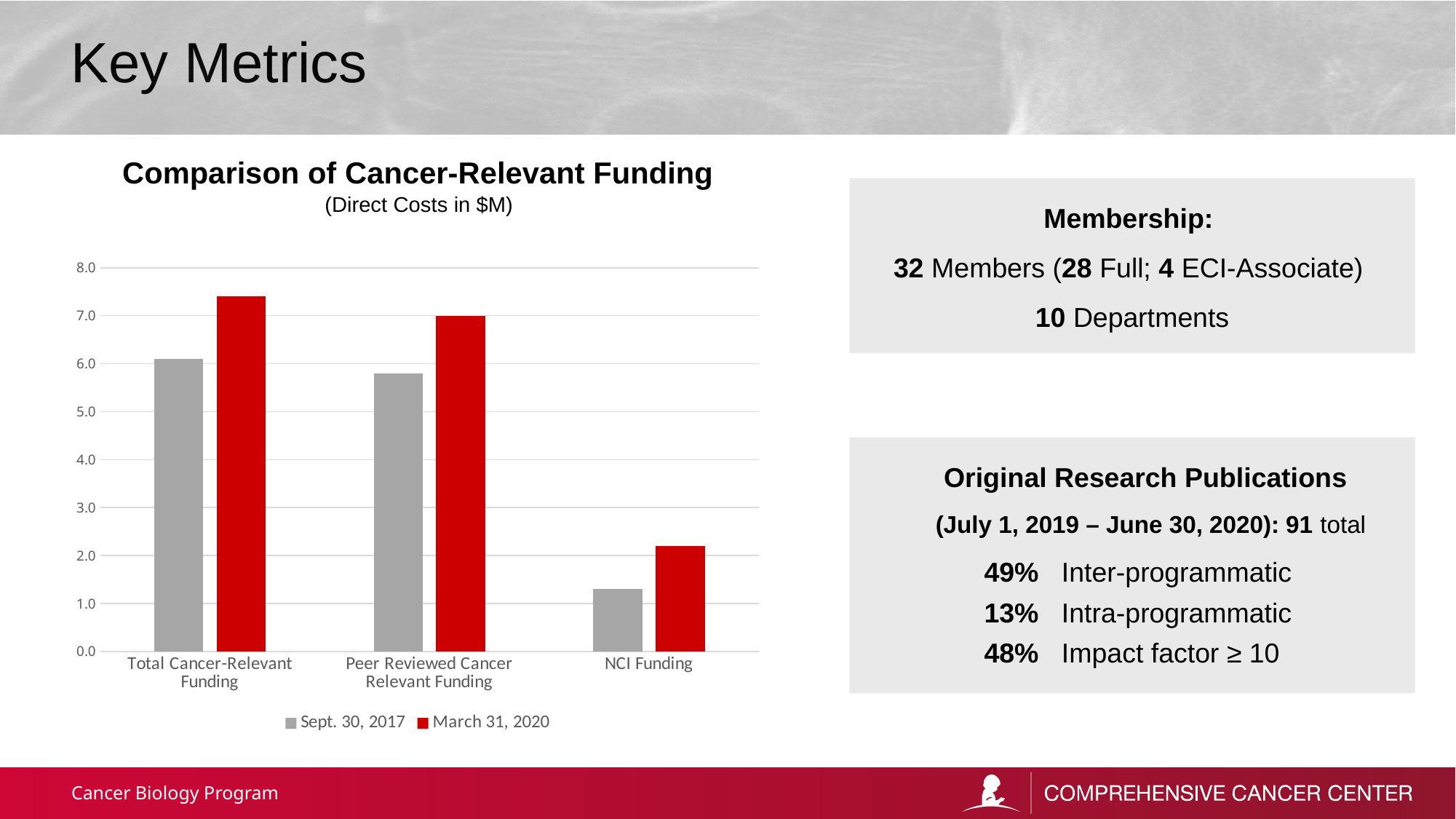
Is the value for Peer Reviewed Cancer Relevant Funding on Sept. 30, 2017 greater or less than 5.0? greater How many series does the chart legend list? 2 Is the value for NCI Funding on March 31, 2020 greater or less than 2.0? greater What kind of chart is shown on the slide? bar chart Which series is shown in red in the chart? March 31, 2020 How many categories are shown on the x axis of the chart? 3 Is the value for Total Cancer-Relevant Funding on March 31, 2020 greater or less than 7.0? greater Which category has the lowest value for March 31, 2020? NCI Funding Which category has the highest value for Sept. 30, 2017? Total Cancer-Relevant Funding For Total Cancer-Relevant Funding, which is larger: the Sept. 30, 2017 value or the March 31, 2020 value? March 31, 2020 What unit is stated in the chart's subtitle? Direct Costs in $M